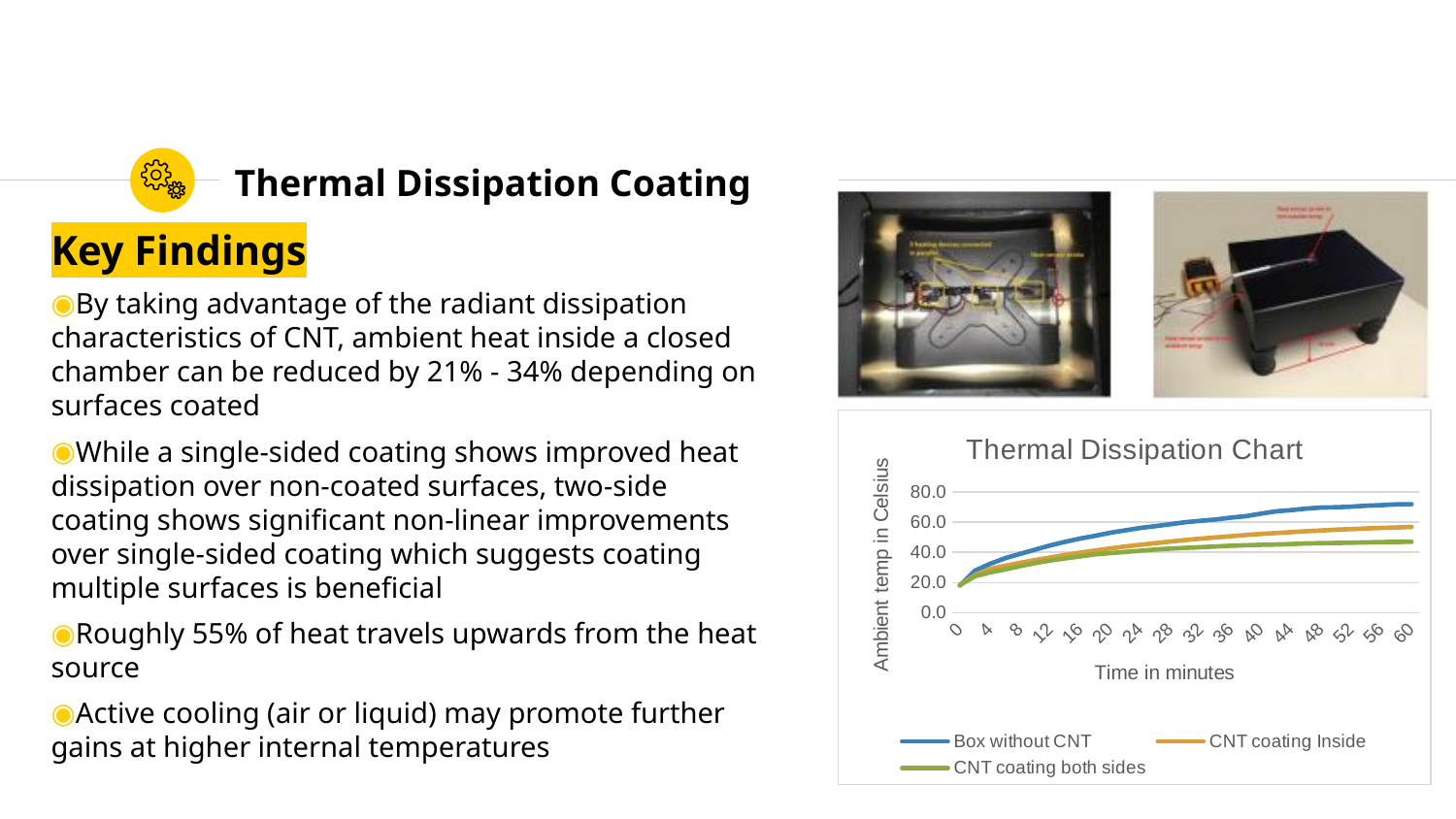
What kind of chart is the Thermal Dissipation Chart? line chart What is the title of the chart on the slide? Thermal Dissipation Chart On the Thermal Dissipation Chart, is the value for CNT coating both sides at 60 minutes greater or less than 60.0? less On the Thermal Dissipation Chart, is the value for CNT coating Inside at 60 minutes greater or less than 40.0? greater Which series on the Thermal Dissipation Chart has the lowest temperature at 60 minutes? CNT coating both sides Do the values for Box without CNT on the Thermal Dissipation Chart rise or fall as time increases? rise Which series on the Thermal Dissipation Chart has the highest temperature at 60 minutes? Box without CNT What is the label of the y axis on the Thermal Dissipation Chart? Ambient temp in Celsius How many time ticks are labeled on the x axis of the Thermal Dissipation Chart? 16 On the Thermal Dissipation Chart, which is larger at 40 minutes: Box without CNT or CNT coating both sides? Box without CNT How many series does the legend of the Thermal Dissipation Chart list? 3 On the Thermal Dissipation Chart, is the value for Box without CNT at 60 minutes greater or less than 60.0? greater